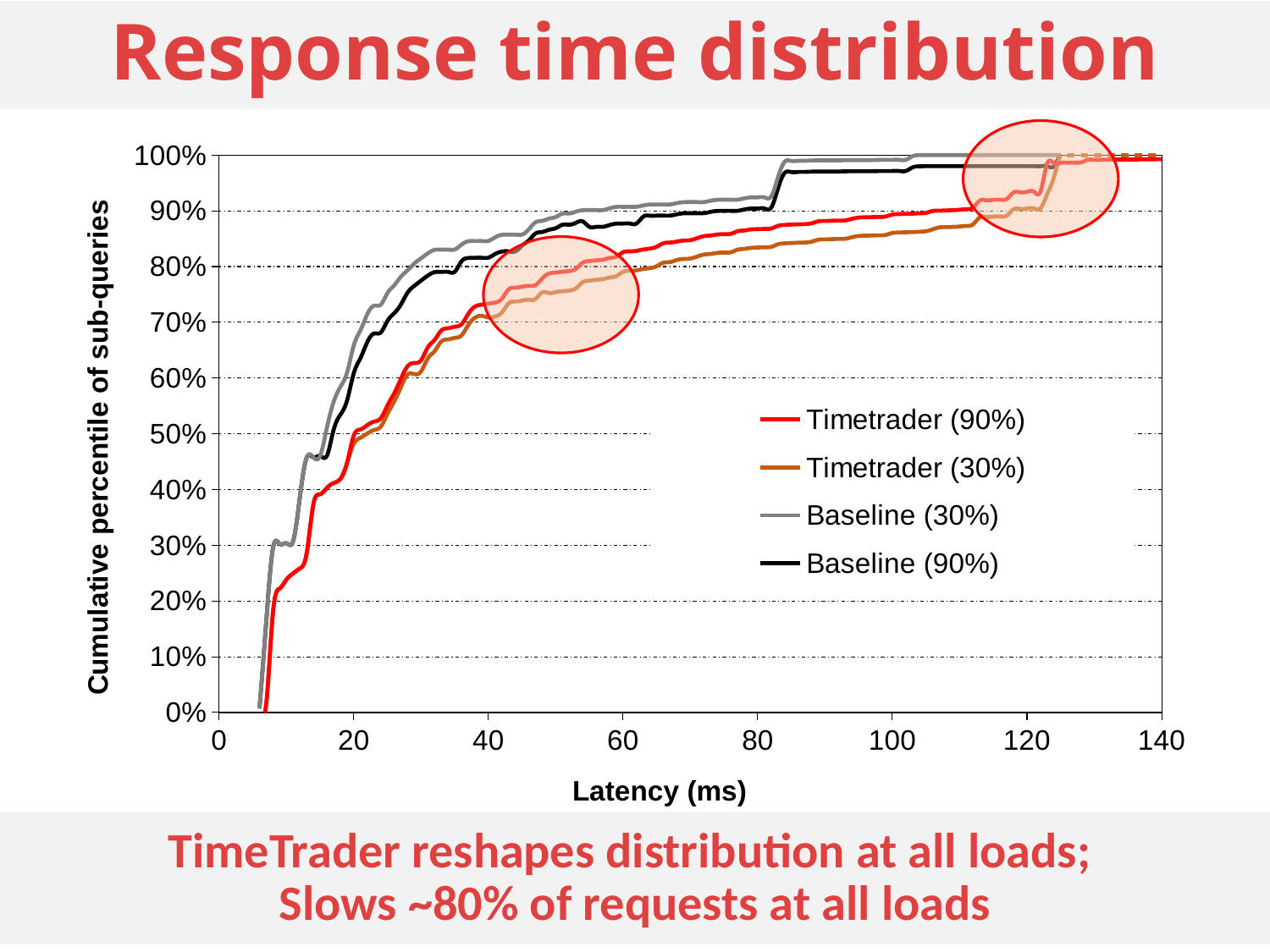
Is the value for Timetrader (30%) at a latency of 100 ms greater or less than 90%? less At a latency of 100 ms, which series has the higher value: Baseline (90%) or Timetrader (30%)? Baseline (90%) What is the title of the x axis? Latency (ms) What is the title of the y axis? Cumulative percentile of sub-queries Is the value for Baseline (90%) at a latency of 60 ms greater or less than 80%? greater How many series does the legend list? 4 What kind of chart is shown on the slide? line chart Is the value for Timetrader (90%) at a latency of 40 ms greater or less than 80%? less At a latency of 40 ms, which series has the higher value: Baseline (30%) or Timetrader (90%)? Baseline (30%) Do the plotted values rise or fall as latency increases along the x axis? rise